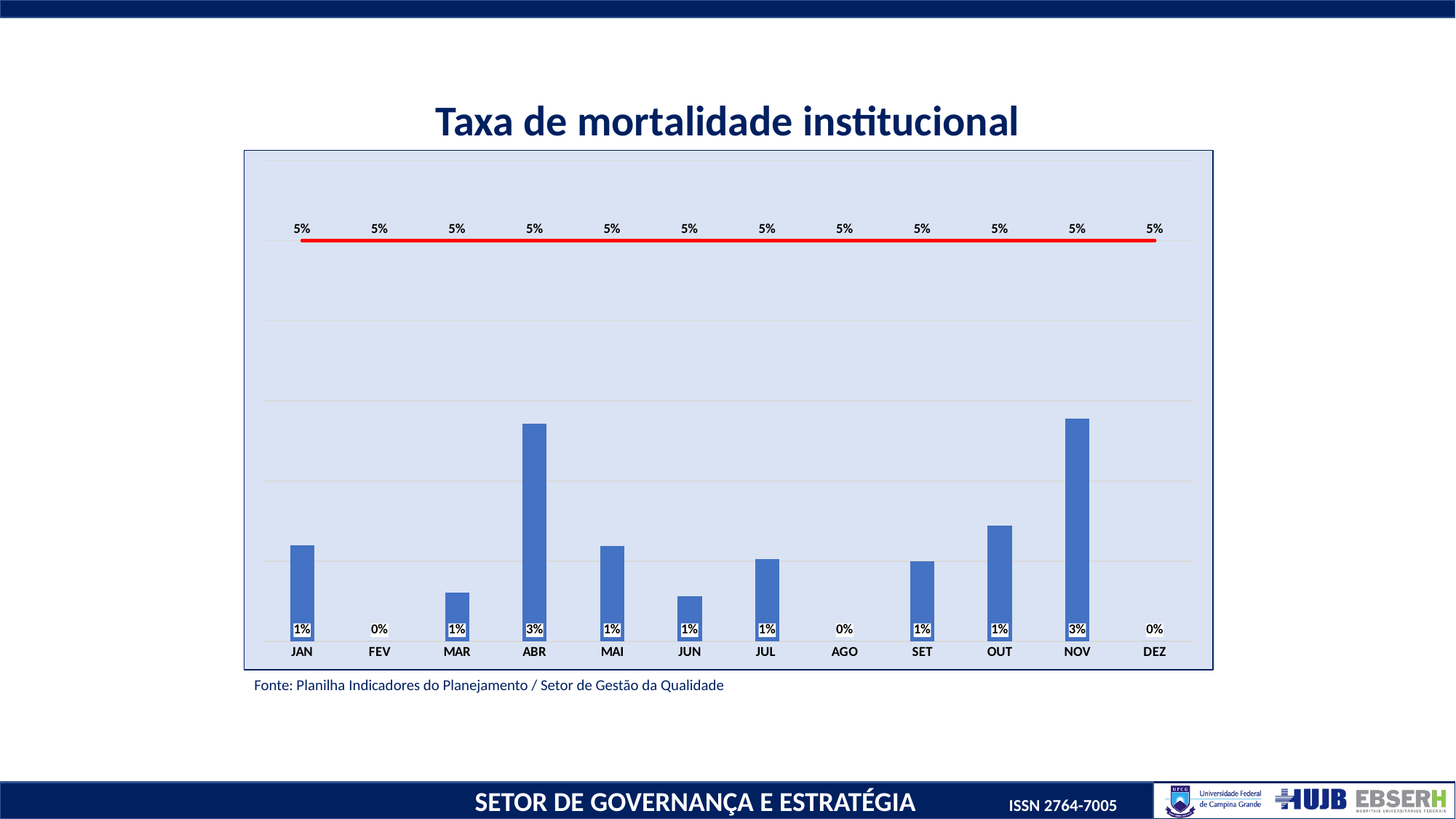
What is the value labeled for AGO? 0% What is the title of the chart? Taxa de mortalidade institucional What value does the red line show for each month? 5% What is the value labeled for DEZ? 0% Is the value for NOV greater or less than the 5% red line? less What type of chart is shown on the slide? combination bar and line chart How many months are shown on the x axis of the chart? 12 Which is larger, the value for ABR or the value for JUN? ABR What is the value labeled for JAN? 1% What is the value labeled for ABR? 3% What is the difference between the value for NOV and the value for SET? 2% What is the value labeled for NOV? 3%